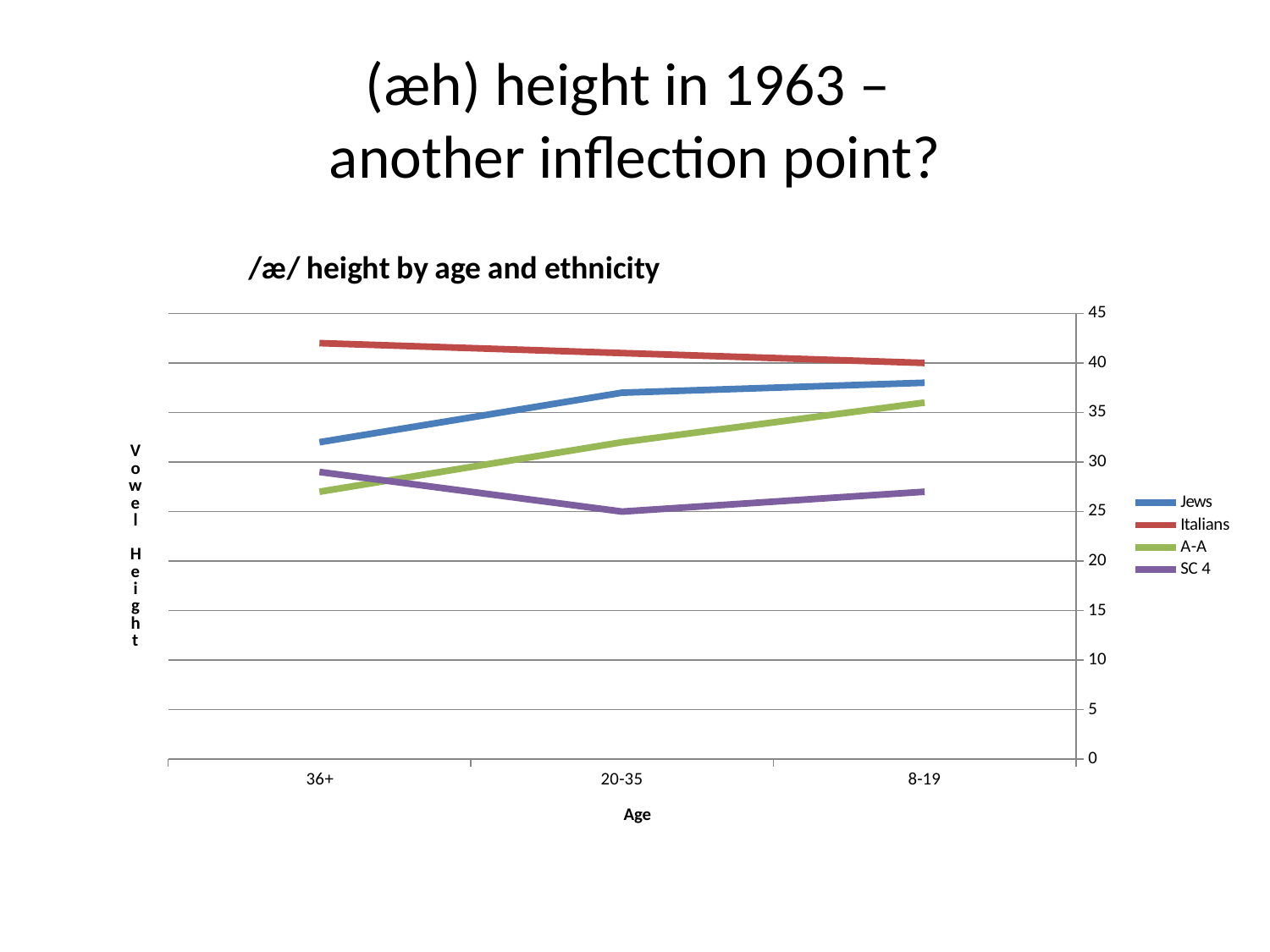
What is the title of the chart? /æ/ height by age and ethnicity Which is larger at age 8-19, the value for Jews or the value for SC 4? Jews Do the values for Italians rise or fall from 36+ to 8-19? fall Is the value for A-A at age 36+ greater or less than 30? less Is the value for Jews at age 36+ greater or less than 30? greater Do the values for A-A rise or fall from 36+ to 8-19? rise Is the value for Italians at age 36+ greater or less than 40? greater What kind of chart is shown on the slide? line chart Which group has the highest vowel height for the 36+ age group? Italians How many series does the legend list? 4 How many age groups are shown on the x axis? 3 Which group has the lowest vowel height for the 20-35 age group? SC 4